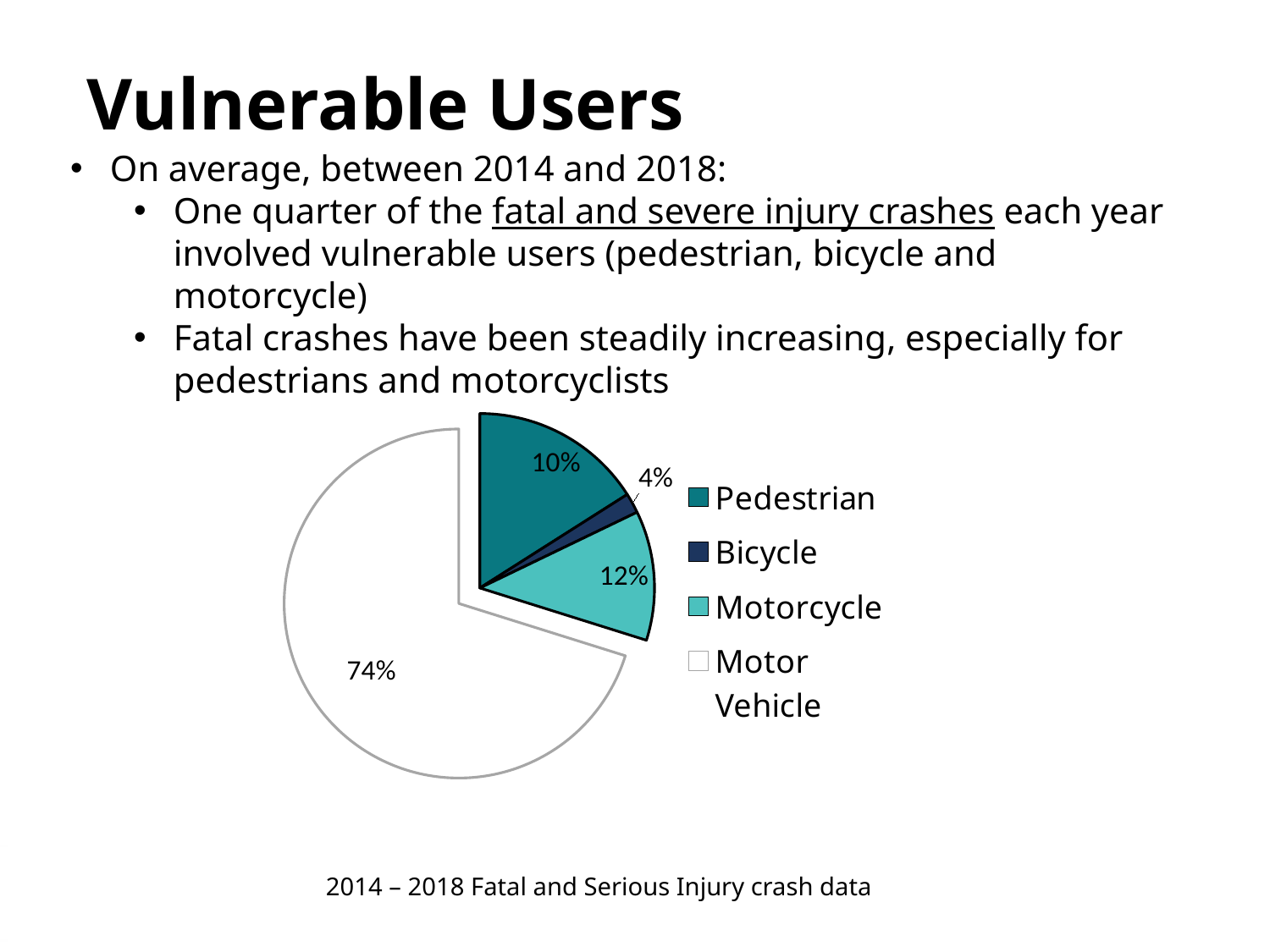
What share of the pie is Pedestrian? 10% Which category has the smallest slice of the pie? Bicycle What share of the pie is Bicycle? 4% What is the difference in percentage points between the Motor Vehicle slice and the Motorcycle slice? 62 How many categories does the pie chart have? 4 What is the difference in percentage points between the Pedestrian slice and the Bicycle slice? 6 Which category has the largest slice of the pie? Motor Vehicle What share of the pie is Motor Vehicle? 74% What kind of chart is shown on the slide? pie chart What share of the pie is Motorcycle? 12% What caption appears below the pie chart? 2014 – 2018 Fatal and Serious Injury crash data